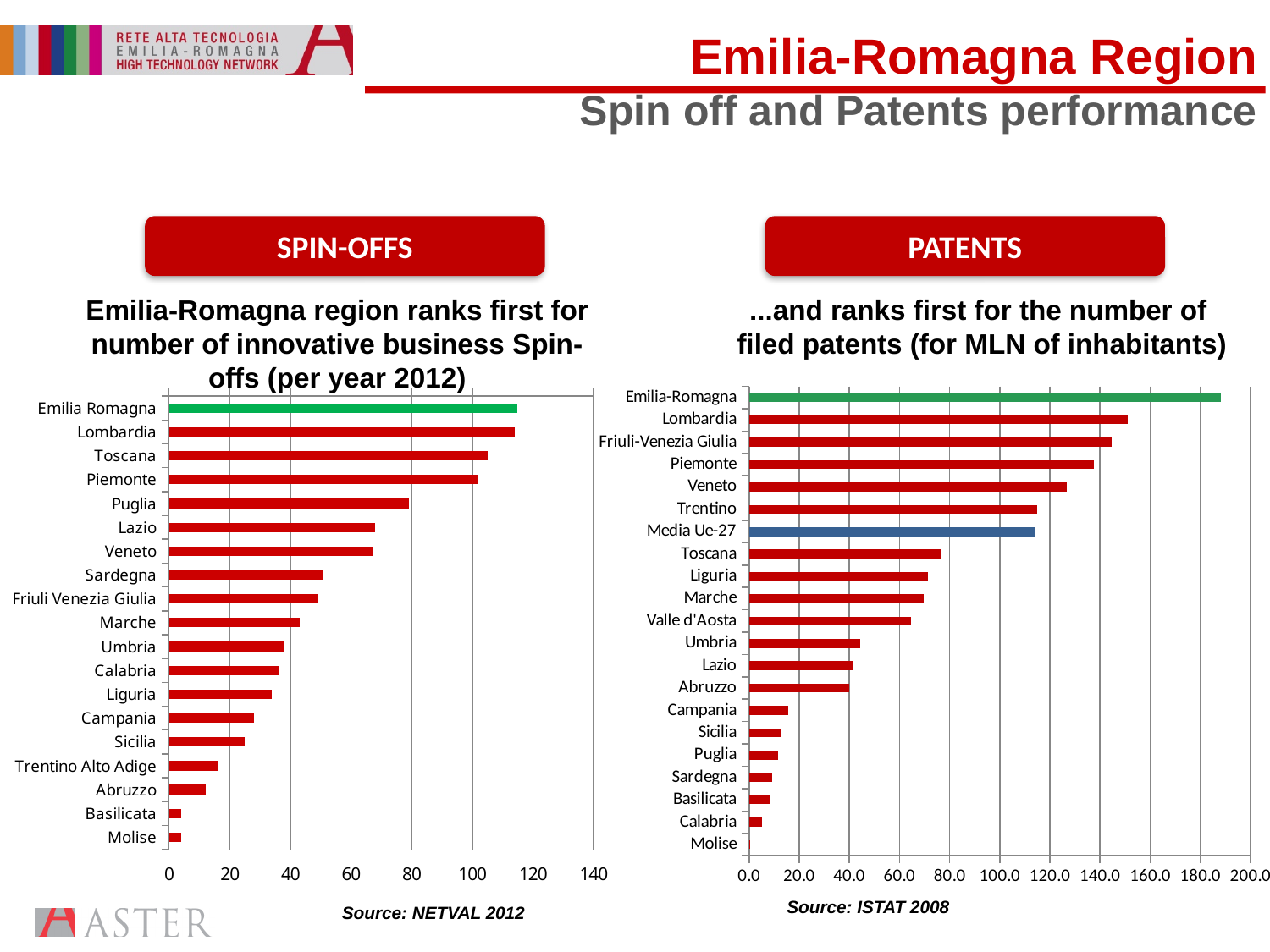
In the PATENTS chart on the right, which category has the lowest value? Molise What is the source cited below the PATENTS chart on the right? ISTAT 2008 In the SPIN-OFFS chart on the left, which is larger, Puglia or Lazio? Puglia How many categories are shown in the PATENTS chart on the right? 21 In the PATENTS chart on the right, is the value for Lombardia greater or less than 140.0? greater What kind of chart is the SPIN-OFFS chart on the left? Bar chart In the PATENTS chart on the right, which is larger, Toscana or Liguria? Toscana In the PATENTS chart on the right, is the value for Campania greater or less than 20.0? less In the SPIN-OFFS chart on the left, is the value for Trentino Alto Adige greater or less than 20? less How many categories are shown in the SPIN-OFFS chart on the left? 19 In the PATENTS chart on the right, which region has the highest value? Emilia-Romagna